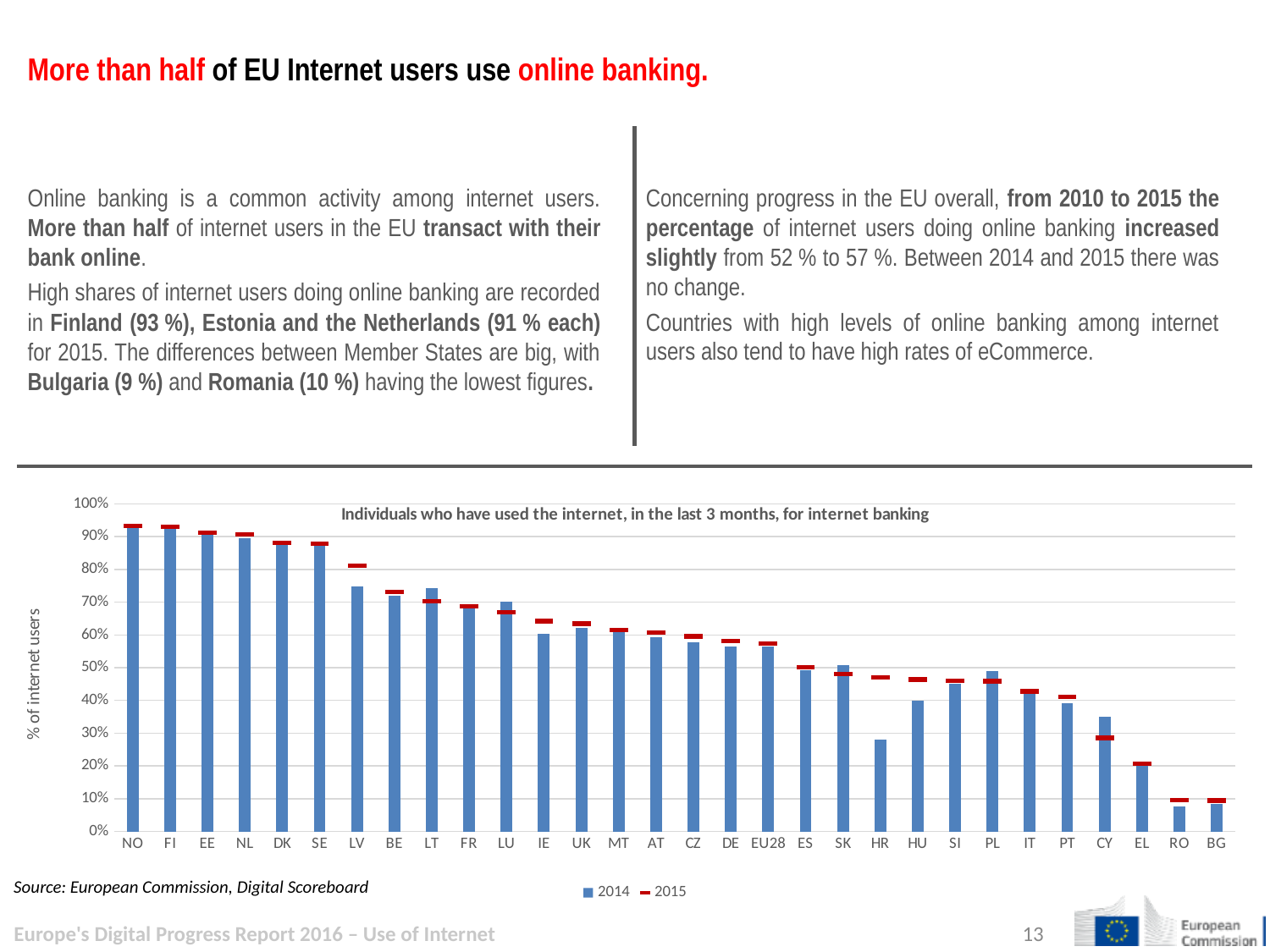
Which category has the lowest 2014 bar in the chart? RO What is the title of the chart? Individuals who have used the internet, in the last 3 months, for internet banking Is the 2014 value for EU28 greater or less than 60%? less How many countries/categories are shown on the x axis of the chart? 30 Which has the larger 2014 value, HR or HU? HU How many series does the chart legend list? 2 Is the 2014 value for HR greater or less than 30%? less Is the 2014 value for NO greater or less than 90%? greater What kind of chart is shown on the slide? bar chart Do the 2014 bar values generally rise or fall from left to right along the x axis? fall